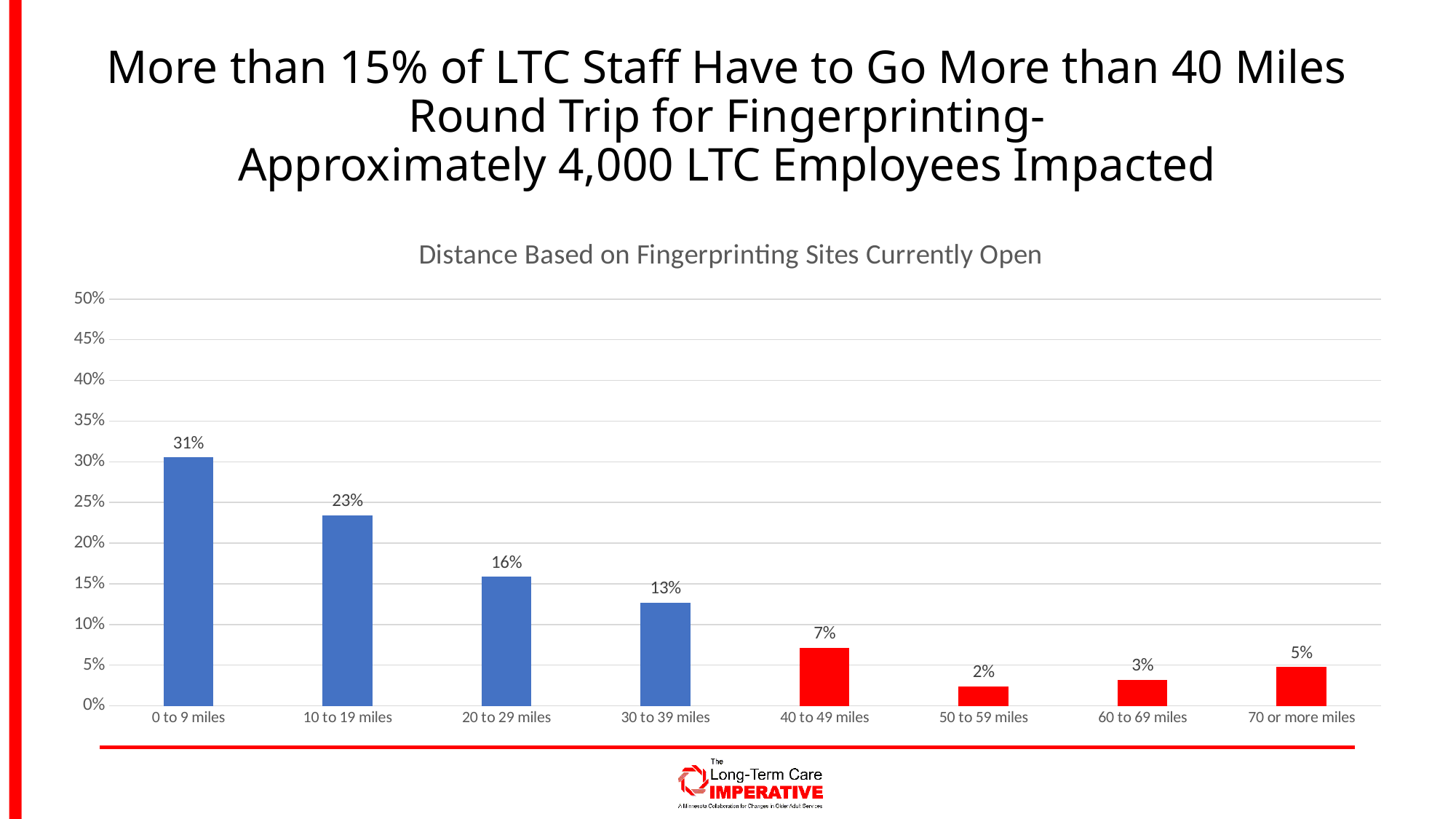
Which is larger, the value for 60 to 69 miles or the value for 70 or more miles? 70 or more miles What is the value for 40 to 49 miles? 7% Is the value for 20 to 29 miles greater or less than 15%? greater How many distance categories are shown on the x axis? 8 What is the value for 0 to 9 miles? 31% Do the values generally rise or fall from 0 to 9 miles to 50 to 59 miles? Fall What kind of chart is shown on the slide? Bar chart Which distance category has the lowest value? 50 to 59 miles What is the value for 70 or more miles? 5% What is the title of the chart? Distance Based on Fingerprinting Sites Currently Open Which distance category has the highest value? 0 to 9 miles What is the difference between the values for 0 to 9 miles and 10 to 19 miles? 8%